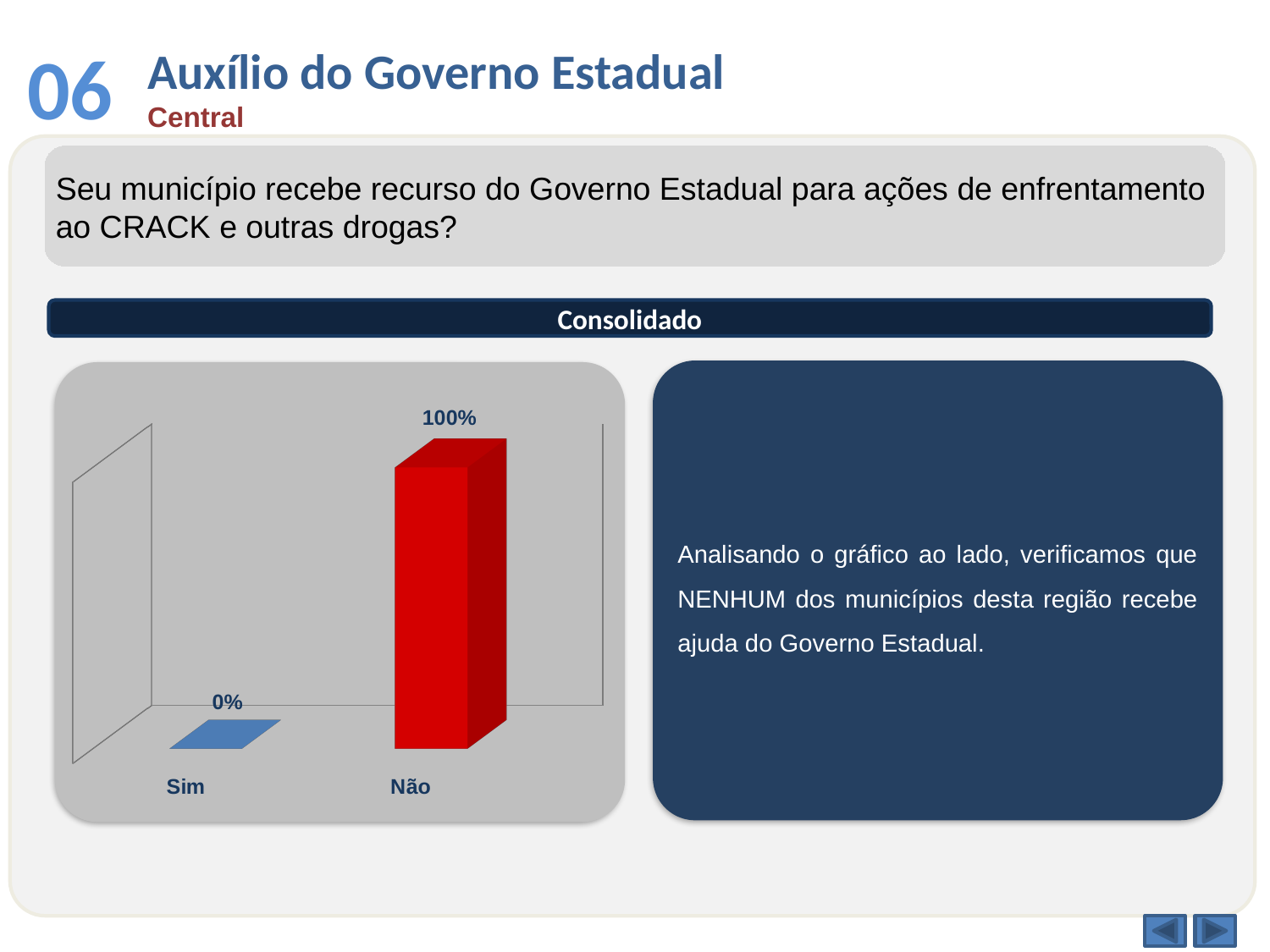
What colour is the bar for "Sim"? Blue Which category has the highest value in the chart? Não Which category has the lowest value in the chart? Sim What kind of chart is shown on the slide? Bar chart How many categories are shown in the chart? 2 What is the value for "Sim" in the chart? 0% What colour is the bar for "Não"? Red What is the difference between the values for "Não" and "Sim"? 100% Which is larger, the value for "Sim" or the value for "Não"? Não What is the value for "Não" in the chart? 100%